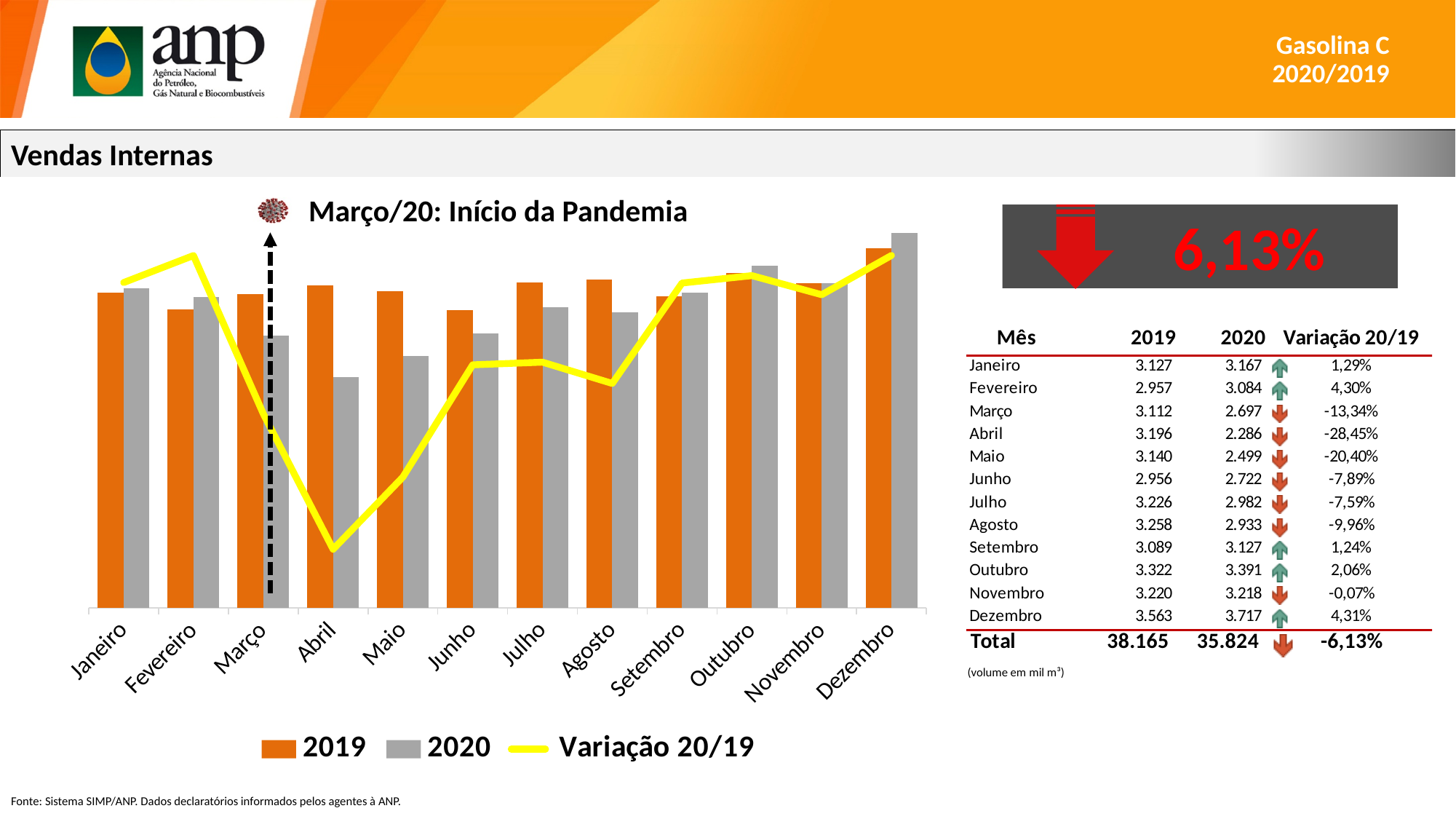
Which month has the highest 2020 bar? Dezembro What is the Variação 20/19 value for Abril? -28,45% What is the 2019 value for Dezembro? 3.563 What kind of chart is shown on the slide? A bar chart combined with a line How many series does the chart legend list? 3 What is the 2020 value for Abril? 2.286 How many months are plotted along the x axis of the chart? 12 Which month has the lowest 2020 bar? Abril Does the Variação 20/19 line rise or fall from Fevereiro to Abril? Fall For Março, which is larger: the 2019 value or the 2020 value? 2019 What are the three entries in the chart legend? 2019, 2020, Variação 20/19 What is the difference between the 2019 and 2020 values for Abril? 910